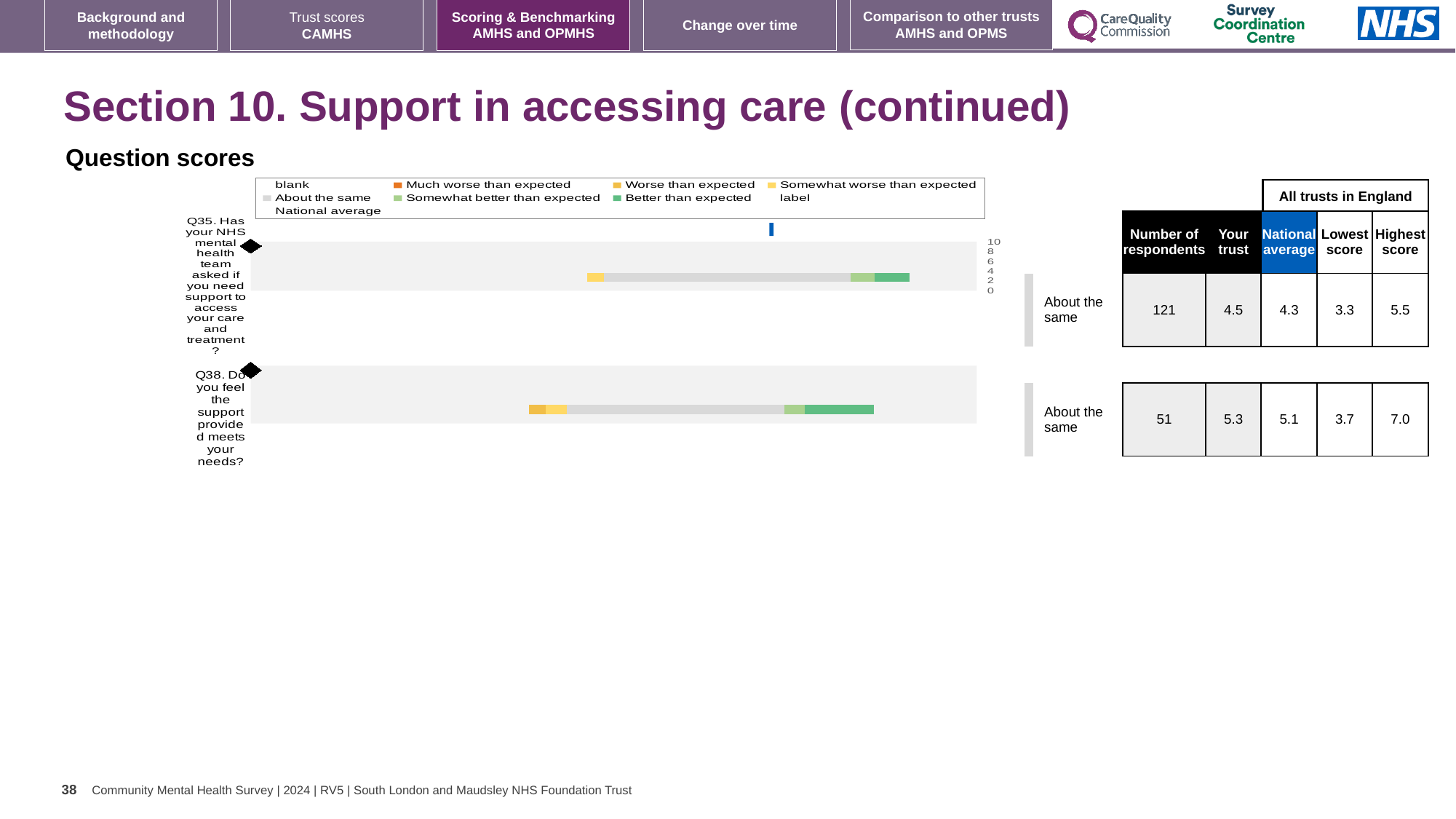
In the table beside the chart, what is the national average for Q35? 4.3 For Q35, what is the difference between the highest score and the lowest score among all trusts in England? 2.2 Which legend entry in the question scores chart is shown in dark green? Better than expected For Q38, which is larger: the 'Your trust' score or the national average? Your trust What kind of chart is used to show the question scores for Q35 and Q38? bar chart Which legend entry in the question scores chart is shown in light grey? About the same In the table beside the chart, what is the highest score among all trusts in England for Q38? 7.0 In the table beside the chart, what is the 'Your trust' score for Q38? 5.3 For Q38, what is the difference between the highest score and the lowest score among all trusts in England? 3.3 How many questions (bars) are plotted in the question scores chart? 2 In the table beside the chart, what is the number of respondents for Q35? 121 What benchmark category is shown next to the Q35 bar? About the same